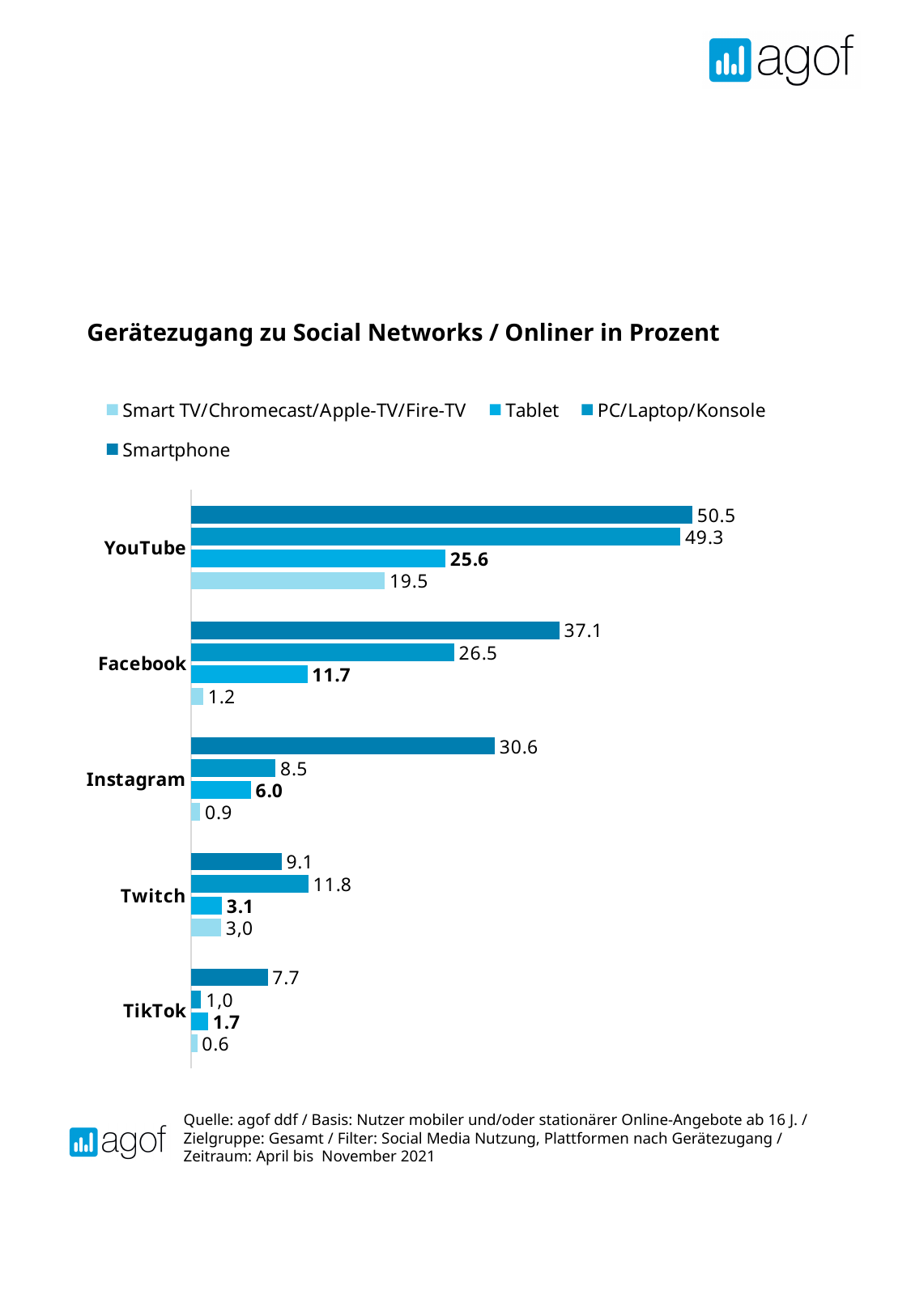
What kind of chart is shown on the slide? bar chart What is the difference between the Smartphone and PC/Laptop/Konsole values for Facebook? 10.6 What is the Smartphone value for YouTube? 50.5 Which social network has the lowest Smart TV/Chromecast/Apple-TV/Fire-TV value? TikTok How many social networks are shown on the chart? 5 What is the PC/Laptop/Konsole value for TikTok? 1,0 What is the Smart TV/Chromecast/Apple-TV/Fire-TV value for Instagram? 0.9 For Twitch, which is larger: the Smartphone value or the PC/Laptop/Konsole value? PC/Laptop/Konsole How many series does the legend list? 4 What is the Tablet value for Facebook? 11.7 What is the PC/Laptop/Konsole value for Twitch? 11.8 Which social network has the highest Smartphone value? YouTube